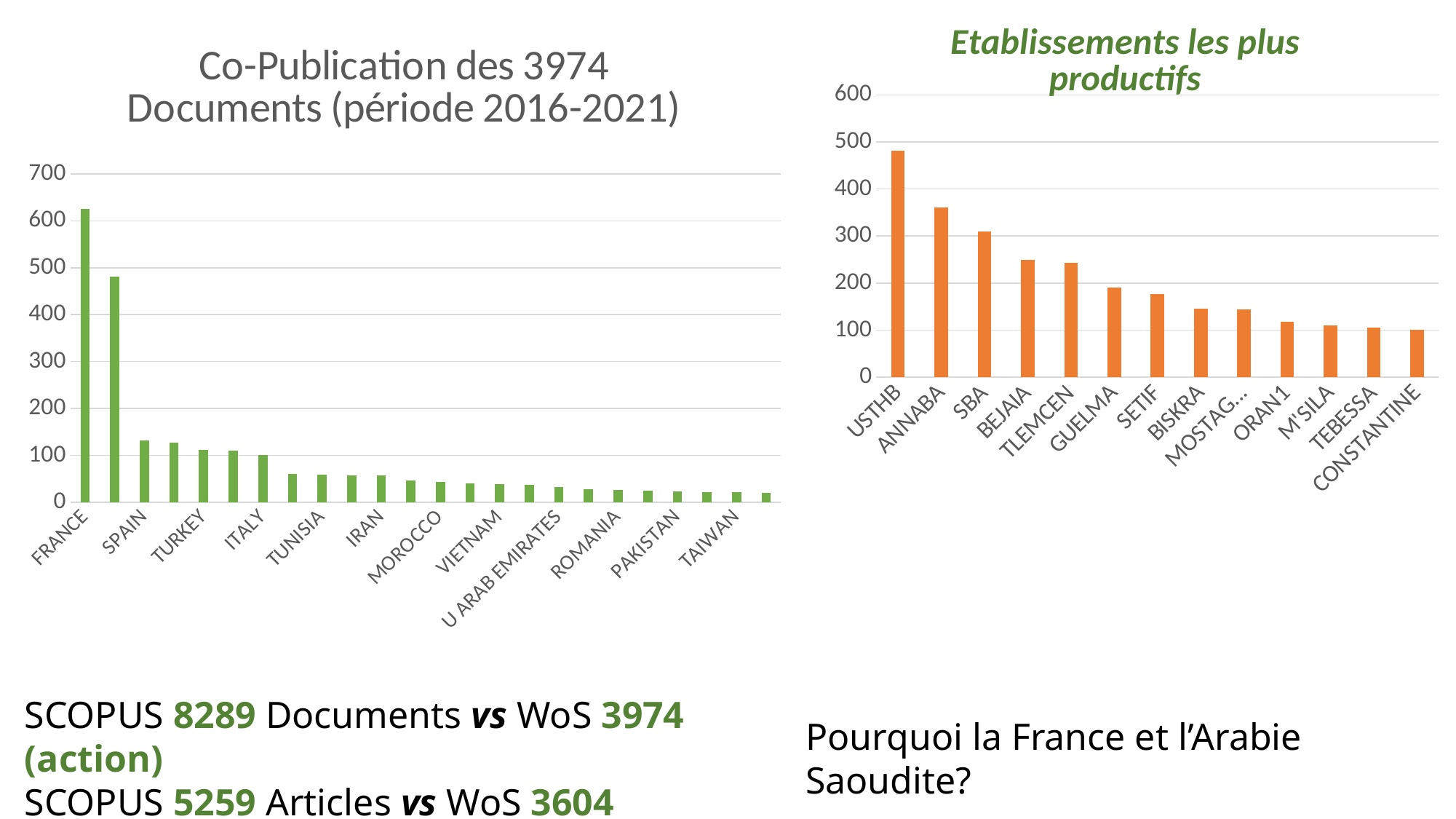
In the 'Co-Publication des 3974 Documents' chart, is the value for FRANCE greater or less than 600? greater In the 'Etablissements les plus productifs' chart, which establishment has the highest value? USTHB In the 'Co-Publication des 3974 Documents' chart, which is larger, the value for FRANCE or the value for SPAIN? FRANCE In the 'Etablissements les plus productifs' chart, do the values rise or fall from left to right? fall In the 'Etablissements les plus productifs' chart, is the value for ANNABA greater or less than 300? greater In the 'Etablissements les plus productifs' chart, is the value for BEJAIA greater or less than 200? greater In the 'Co-Publication des 3974 Documents' chart, which country has the highest value? FRANCE In the 'Etablissements les plus productifs' chart, which is larger, the value for USTHB or the value for SBA? USTHB How many establishments are shown in the 'Etablissements les plus productifs' chart? 13 What kind of chart is the 'Etablissements les plus productifs' chart? bar chart